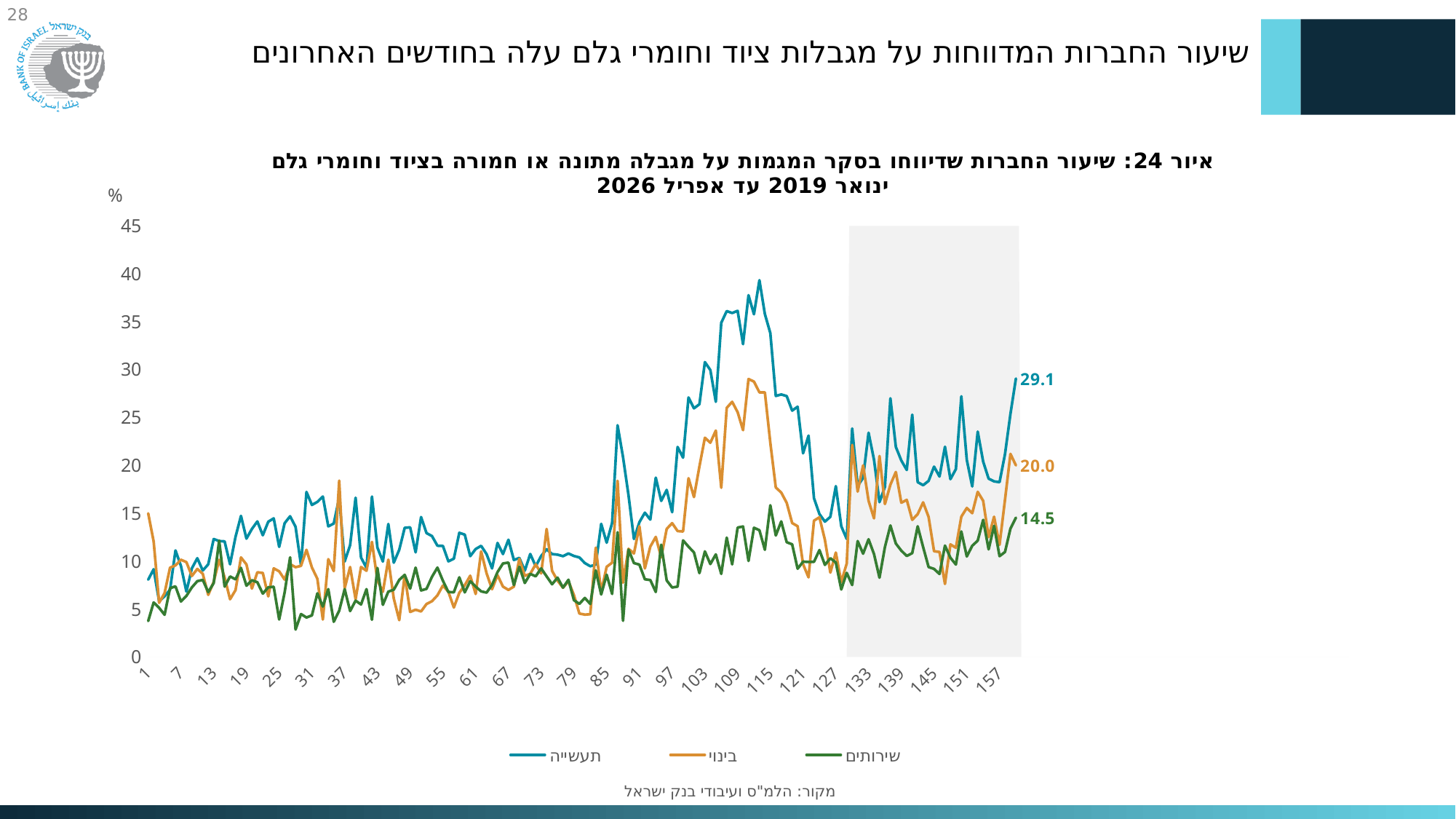
What is the final labelled value for the תעשייה series? 29.1 Is the peak value of the תעשייה series greater or less than 35? greater What is the final labelled value for the בינוי series? 20.0 What kind of chart is shown on the slide? line chart How many series does the legend list? 3 What is the final labelled value for the שירותים series? 14.5 Which series has the highest final labelled value? תעשייה Which series has the lowest final labelled value? שירותים Is the final value of the בינוי series larger or smaller than the final value of the שירותים series? larger Which series is drawn in green in the legend? שירותים What is the difference between the final labelled values of בינוי and שירותים? 5.5 What is the difference between the final labelled values of תעשייה and בינוי? 9.1